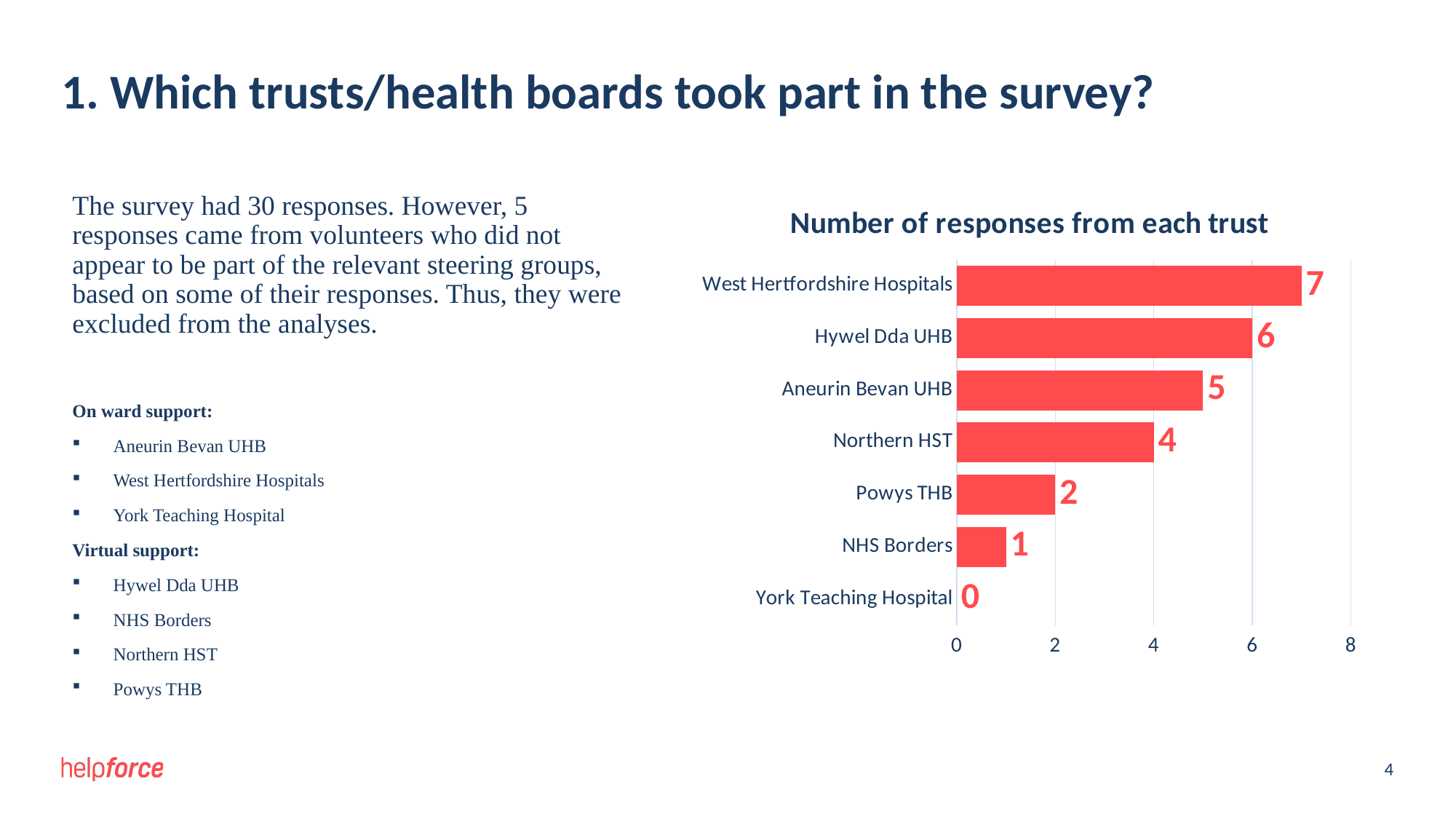
Which had more responses, Hywel Dda UHB or Northern HST? Hywel Dda UHB Which trust had the highest number of responses? West Hertfordshire Hospitals Which trust had the lowest number of responses? York Teaching Hospital How many responses came from York Teaching Hospital? 0 How many responses came from West Hertfordshire Hospitals? 7 What is the title of the chart? Number of responses from each trust What is the difference in responses between West Hertfordshire Hospitals and NHS Borders? 6 How many trusts are shown in the chart? 7 What type of chart is used to show the number of responses from each trust? Bar chart How many responses came from Powys THB? 2 How many responses came from Hywel Dda UHB? 6 What is the difference in responses between Aneurin Bevan UHB and Northern HST? 1